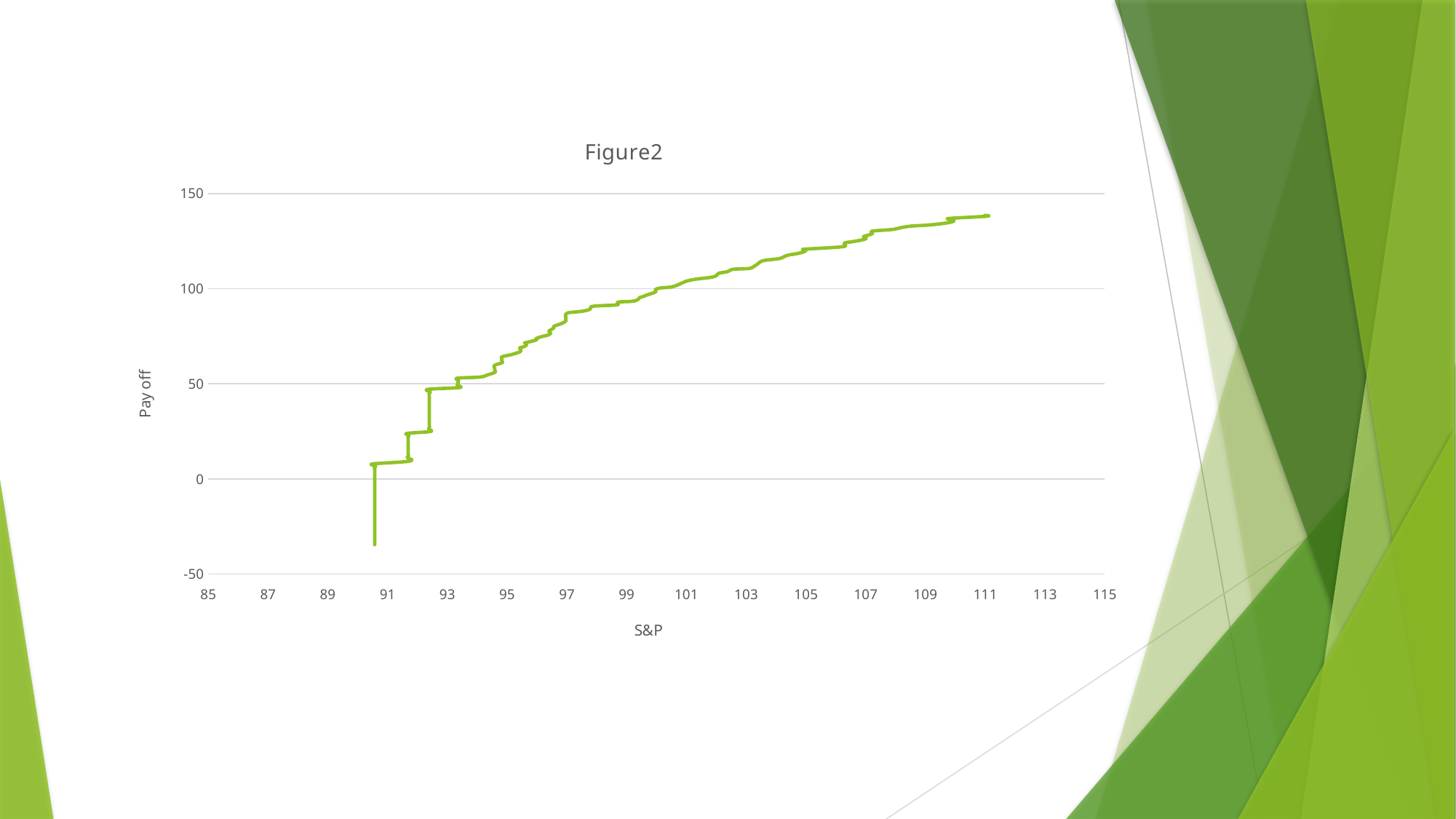
Is the pay off higher at an S&P value of 107 or at an S&P value of 93? 107 What are the x-axis and y-axis titles of the chart? S&P (x-axis) and Pay off (y-axis) Does the pay off generally rise or fall as S&P increases along the x axis? rise Is the pay off at an S&P value of 97 greater or less than 100? less Is the pay off at an S&P value of 103 greater or less than 100? greater Is the pay off at an S&P value of 109 greater or less than 150? less What kind of chart is shown on the slide? line chart What is the title of the chart? Figure2 How many data series are plotted in the chart? 1